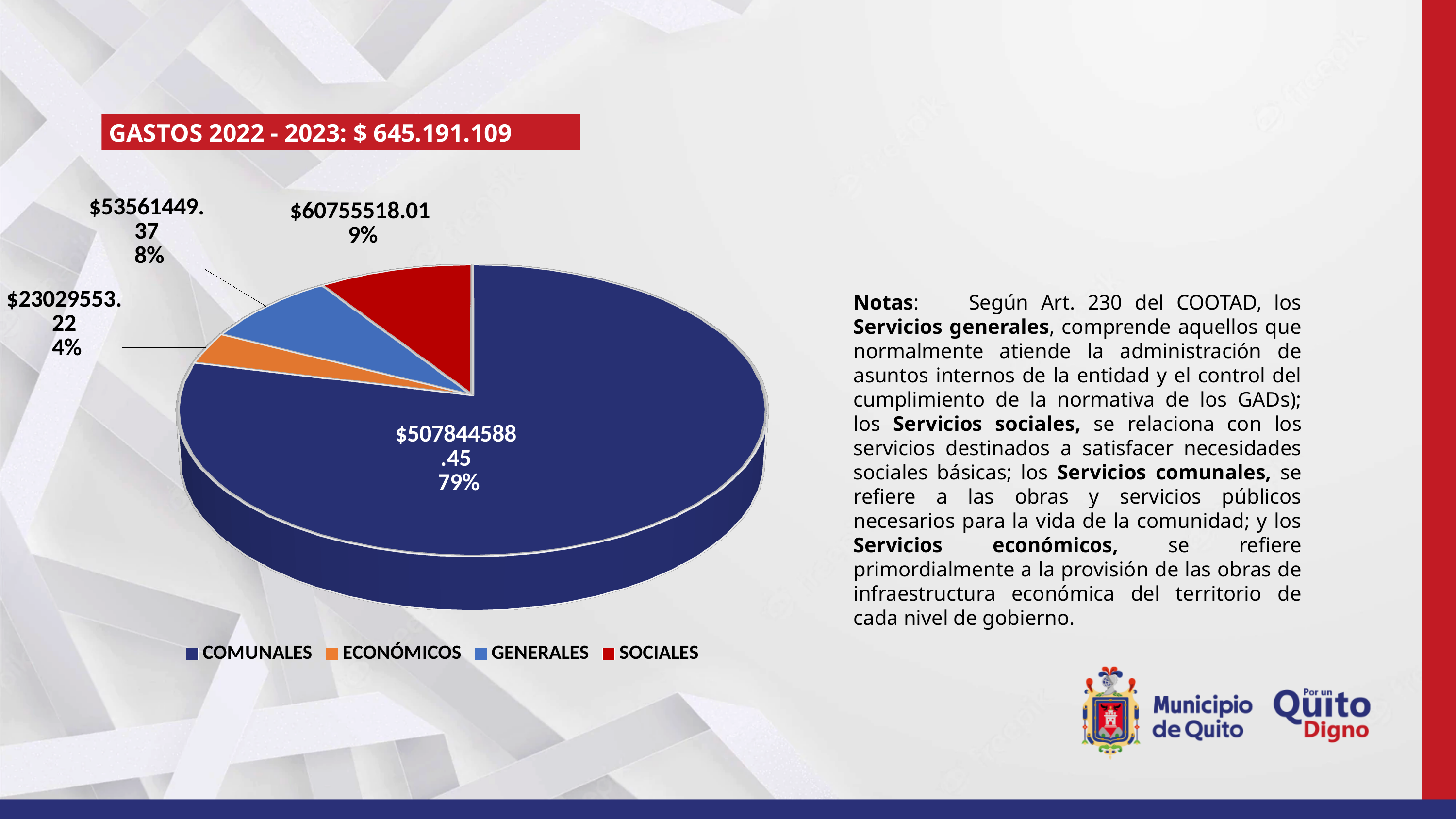
How many categories does the legend list? 4 What is the value shown for ECONÓMICOS? $23029553.22 What percentage share does GENERALES have? 8% What is the value shown for SOCIALES? $60755518.01 What percentage share does COMUNALES have? 79% What is the title shown above the chart? GASTOS 2022 - 2023: $ 645.191.109 What colour is the SOCIALES slice? red What kind of chart is shown on the slide? pie chart Which category has the largest slice? COMUNALES What is the value shown for COMUNALES? $507844588.45 Which is larger, the value for SOCIALES or the value for GENERALES? SOCIALES Which category has the smallest slice? ECONÓMICOS